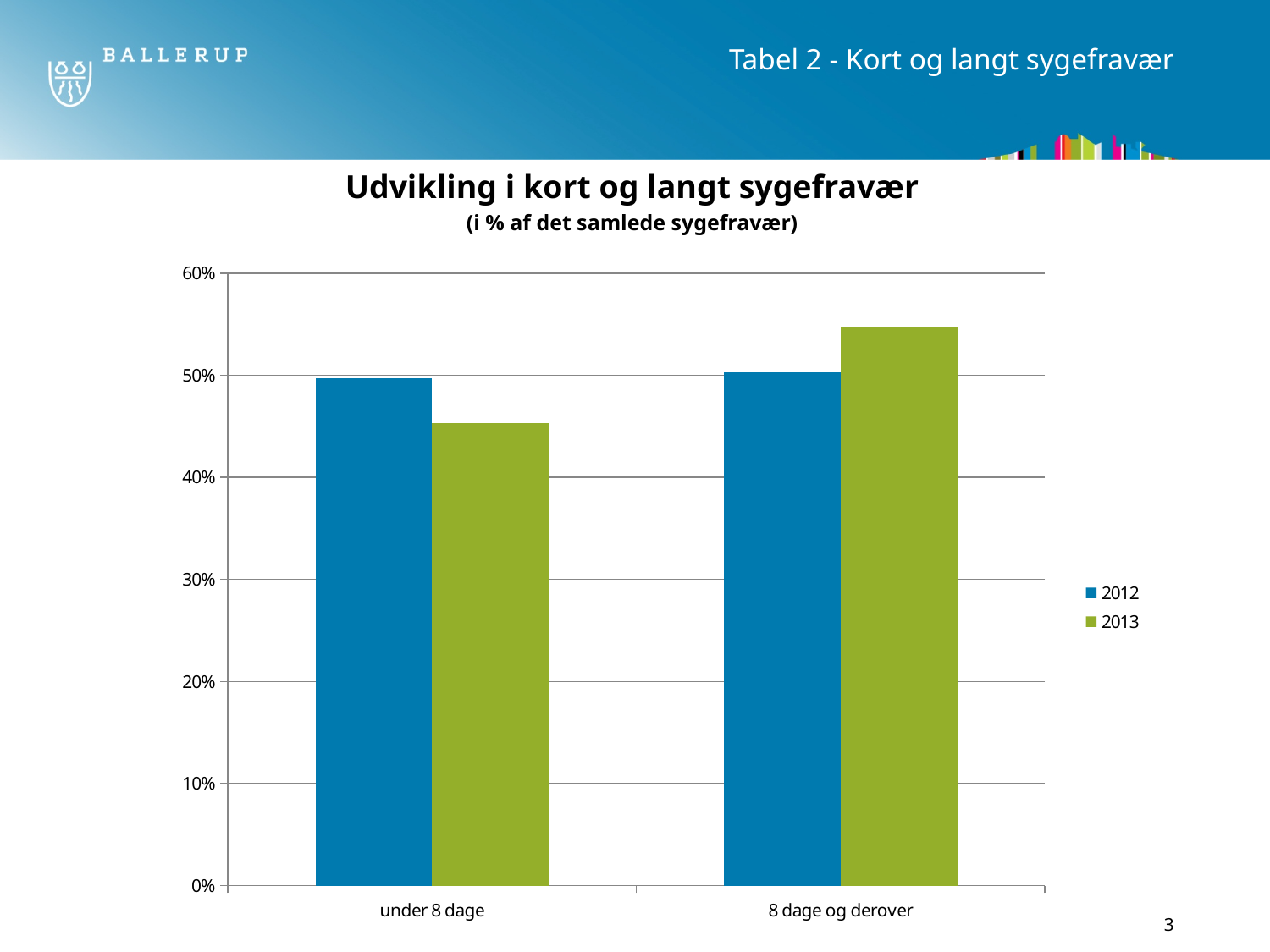
For '8 dage og derover', which year has the larger value, 2012 or 2013? 2013 What is the title of the chart? Udvikling i kort og langt sygefravær Which series is shown in green? 2013 Which category has the highest 2013 value? 8 dage og derover How many categories are shown on the x axis? 2 Is the 2013 value for '8 dage og derover' greater or less than 50%? greater For 'under 8 dage', which year has the larger value, 2012 or 2013? 2012 How many series does the legend list? 2 Is the 2012 value for 'under 8 dage' greater or less than 40%? greater What kind of chart is shown on the slide? bar chart Is the 2013 value for 'under 8 dage' greater or less than 50%? less Which bar is the lowest in the chart? 2013, under 8 dage